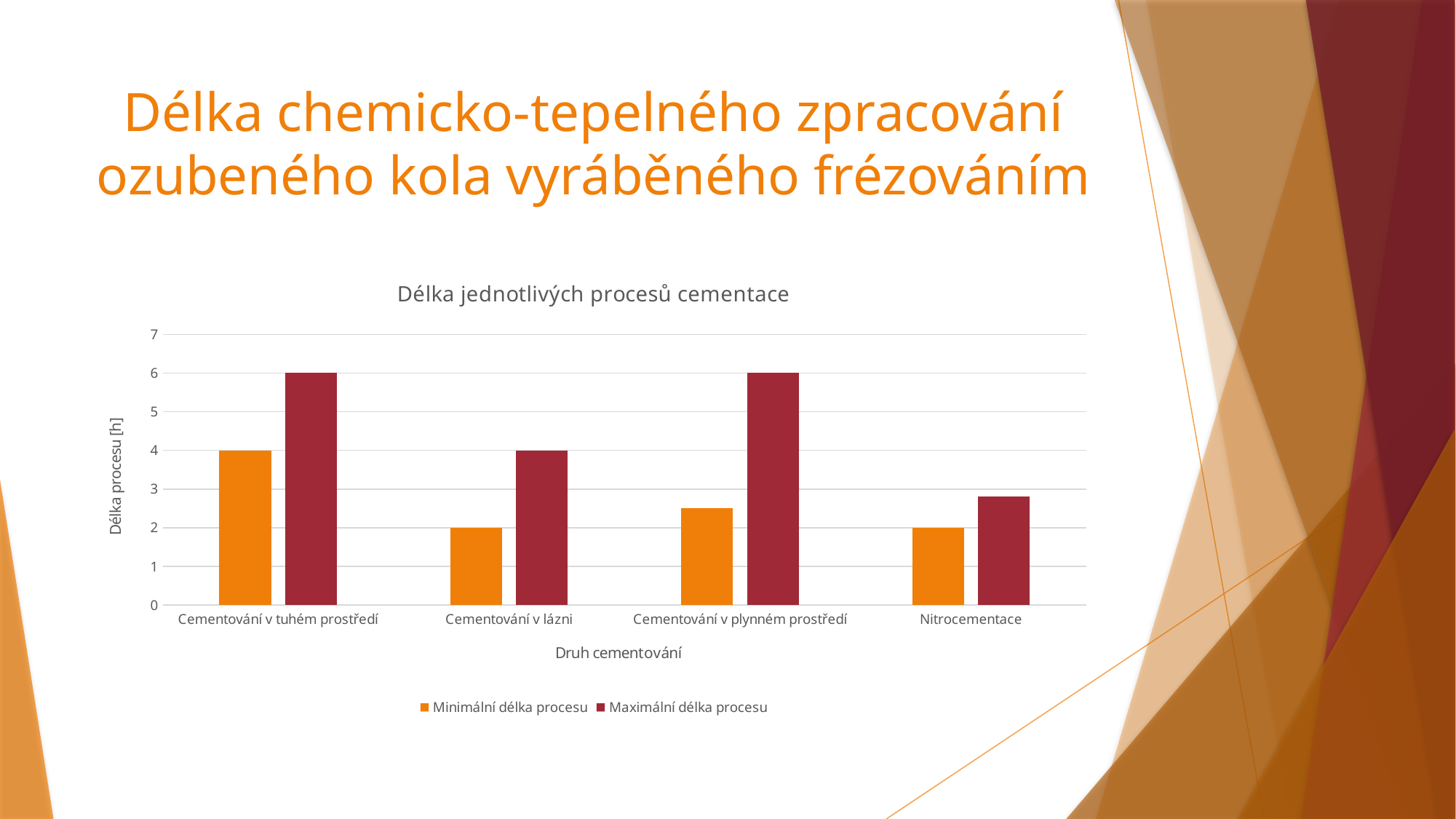
Which category has the lowest value for Maximální délka procesu? Nitrocementace What kind of chart is shown on the slide? bar chart What is the value of Maximální délka procesu for Cementování v plynném prostředí? 6 What is the value of Maximální délka procesu for Cementování v lázni? 4 Which category has the highest value for Minimální délka procesu? Cementování v tuhém prostředí Is the value of Maximální délka procesu for Nitrocementace greater or less than 3? less How many categories are shown on the x axis? 4 What is the value of Maximální délka procesu for Cementování v tuhém prostředí? 6 How many series does the legend list? 2 What is the title of the chart? Délka jednotlivých procesů cementace What is the value of Minimální délka procesu for Cementování v tuhém prostředí? 4 What is the difference between Maximální délka procesu and Minimální délka procesu for Cementování v lázni? 2